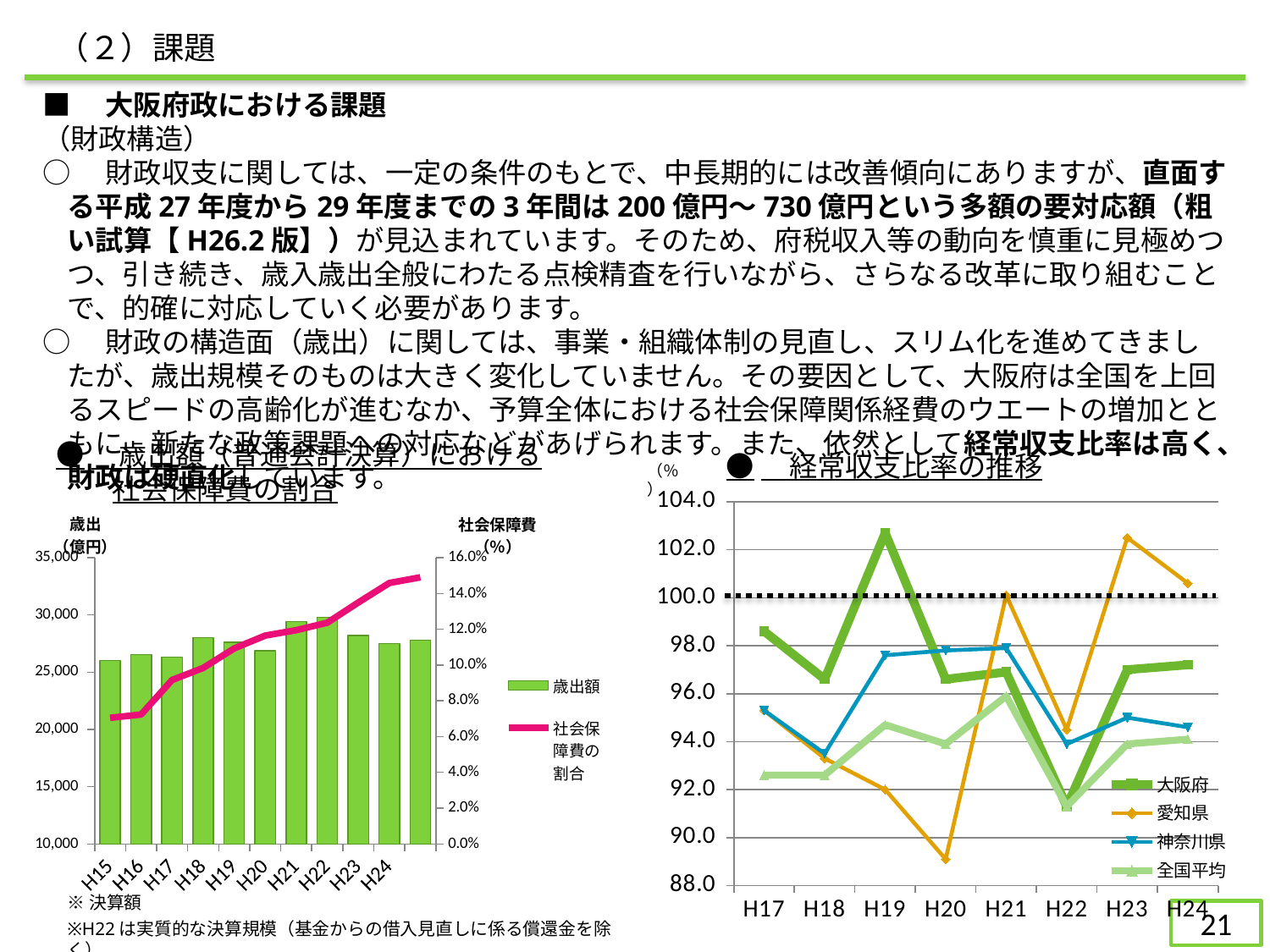
In the left-hand chart (歳出額における社会保障費の割合), what are the two legend entries? 歳出額, 社会保障費の割合 In the left-hand chart (歳出額における社会保障費の割合), how many fiscal years are shown on the x axis? 10 In the right-hand chart (経常収支比率の推移), which series has the lowest value at H20? 愛知県 In the left-hand chart (歳出額における社会保障費の割合), does the 社会保障費の割合 line rise or fall from H15 to H24? rise In the right-hand chart (経常収支比率の推移), how many fiscal years are shown on the x axis? 8 In the right-hand chart (経常収支比率の推移), at H23, which is larger: the value for 愛知県 or the value for 全国平均? 愛知県 In the right-hand chart (経常収支比率の推移), is the value for 大阪府 at H19 greater or less than 102.0? greater In the right-hand chart (経常収支比率の推移), is the value for 愛知県 at H20 greater or less than 90.0? less In the right-hand chart (経常収支比率の推移), which series has the highest value at H19? 大阪府 In the right-hand chart (経常収支比率の推移), how many series does the legend list? 4 In the left-hand chart (歳出額における社会保障費の割合), is the 社会保障費の割合 value for H24 greater or less than 14.0%? greater What kind of chart is the right-hand chart titled 経常収支比率の推移? line chart